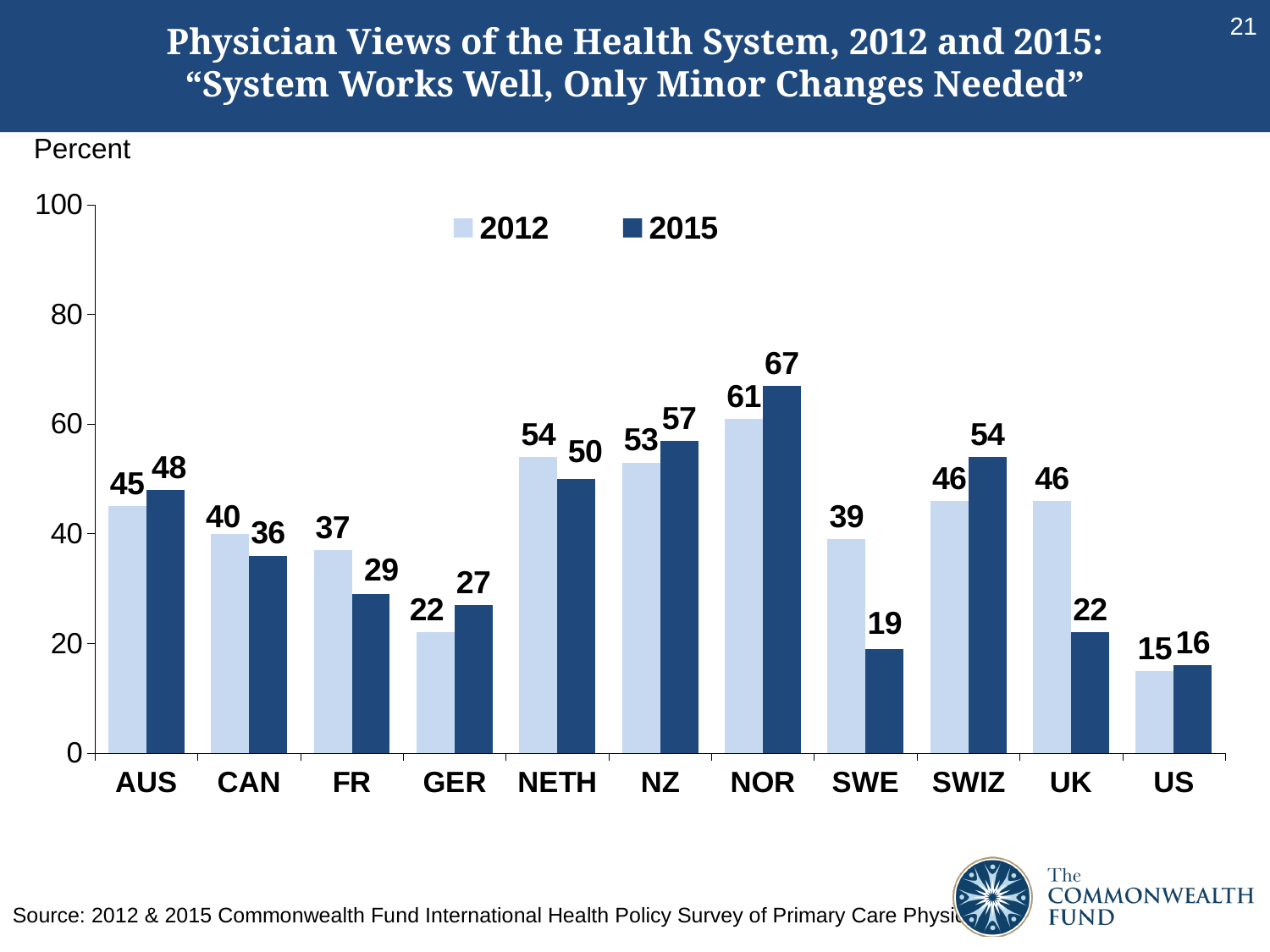
What is the 2015 value for UK? 22 Is the 2015 value for NETH greater or less than 40? greater Which country has the highest 2015 value? NOR What are the two series listed in the legend? 2012 and 2015 How many series does the legend list? 2 What kind of chart is shown on the slide? bar chart What is the difference between the 2012 and 2015 values for SWE? 20 What is the 2012 value for SWE? 39 How many countries are shown on the x axis? 11 Which country has the lowest 2012 value? US Which is larger for CAN, the 2012 value or the 2015 value? 2012 What is the 2015 value for NOR? 67